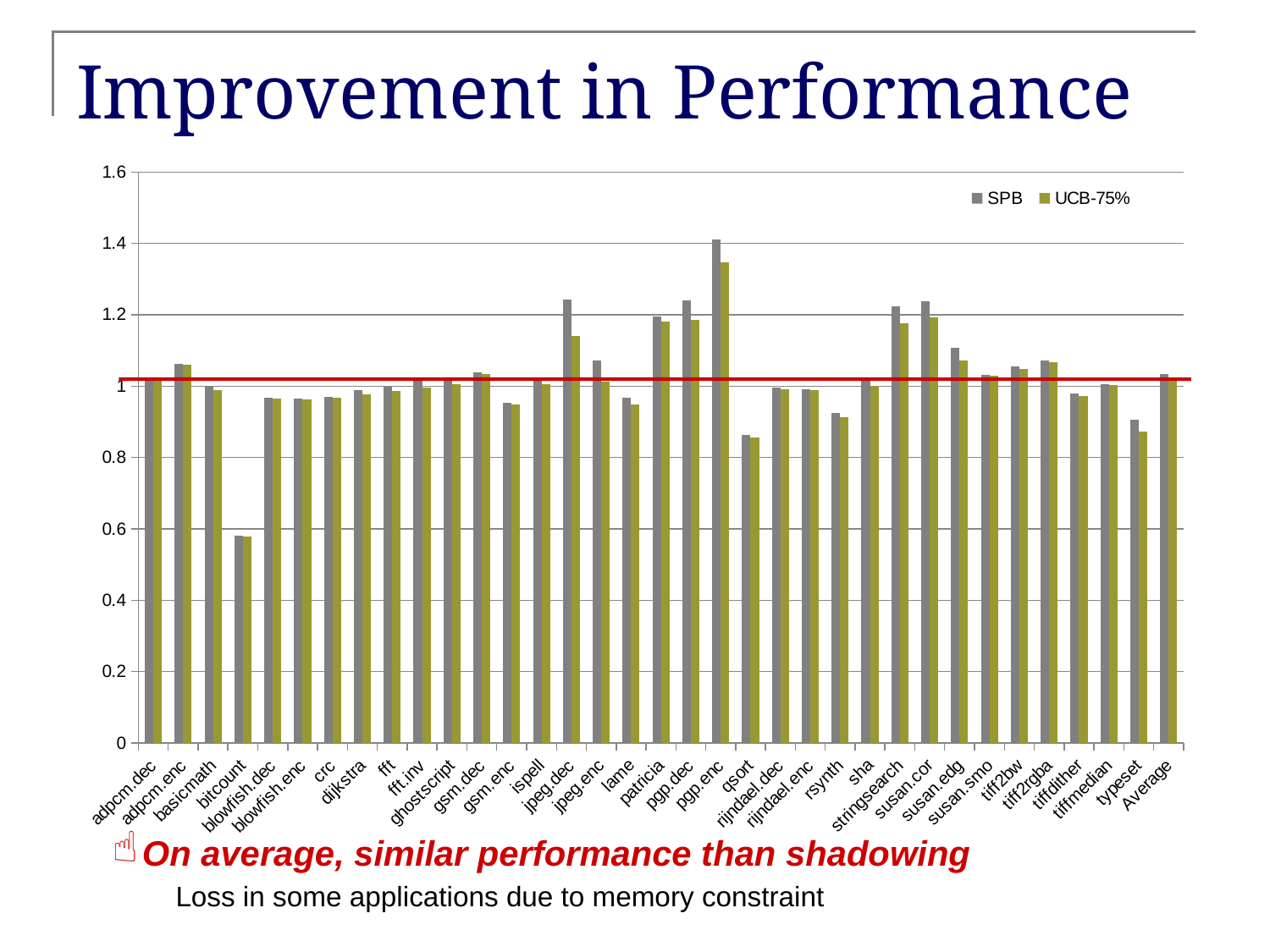
Which category has the highest SPB value? pgp.enc Is the UCB-75% value for typeset greater or less than 1? less Which category has the lowest UCB-75% value? bitcount For pgp.enc, which series has the larger value, SPB or UCB-75%? SPB Which has the larger SPB value, jpeg.dec or qsort? jpeg.dec How many series does the legend list? 2 Which category has the lowest SPB value? bitcount Is the SPB value for bitcount greater or less than 0.8? less Is the SPB value for pgp.enc greater or less than 1.2? greater What are the names of the two series in the legend? SPB and UCB-75% What kind of chart is shown on the slide? bar chart How many categories are shown along the x axis, including Average? 35